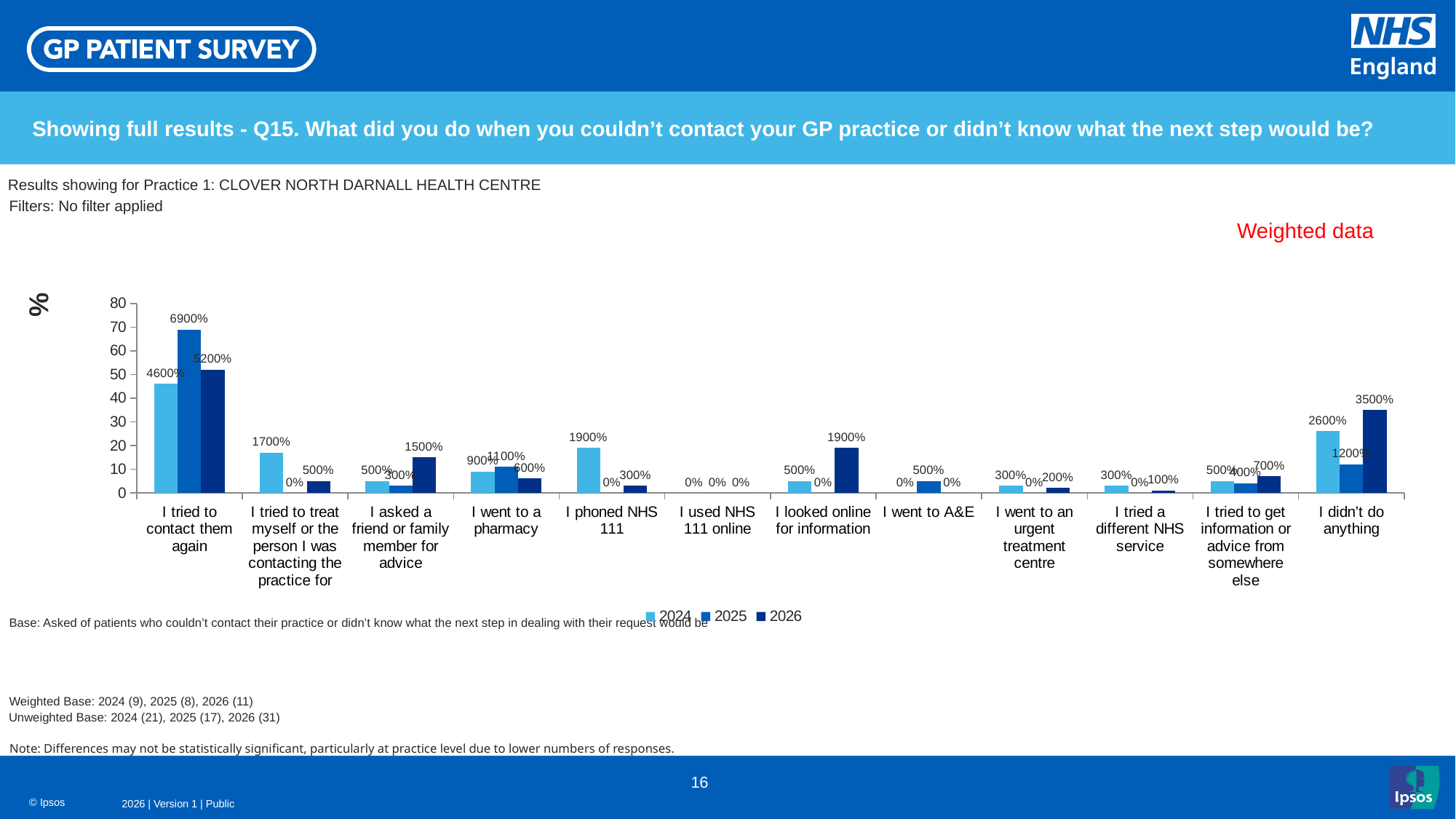
What is the difference between the 2025 and 2026 values for "I tried to contact them again"? 1700% What is the 2026 value for "I didn't do anything"? 3500% What is the 2026 value for "I looked online for information"? 1900% What kind of chart is shown on the slide? Bar chart How many categories are shown on the x axis? 12 What is the 2025 value for "I tried to contact them again"? 6900% Which is larger for "I didn't do anything": the 2024 value or the 2026 value? 2026 Which category has the highest 2024 value? I tried to contact them again What is the 2024 value for "I phoned NHS 111"? 1900% Which category has the highest 2026 value? I tried to contact them again What are the series names listed in the legend? 2024, 2025, 2026 How many series does the legend list? 3